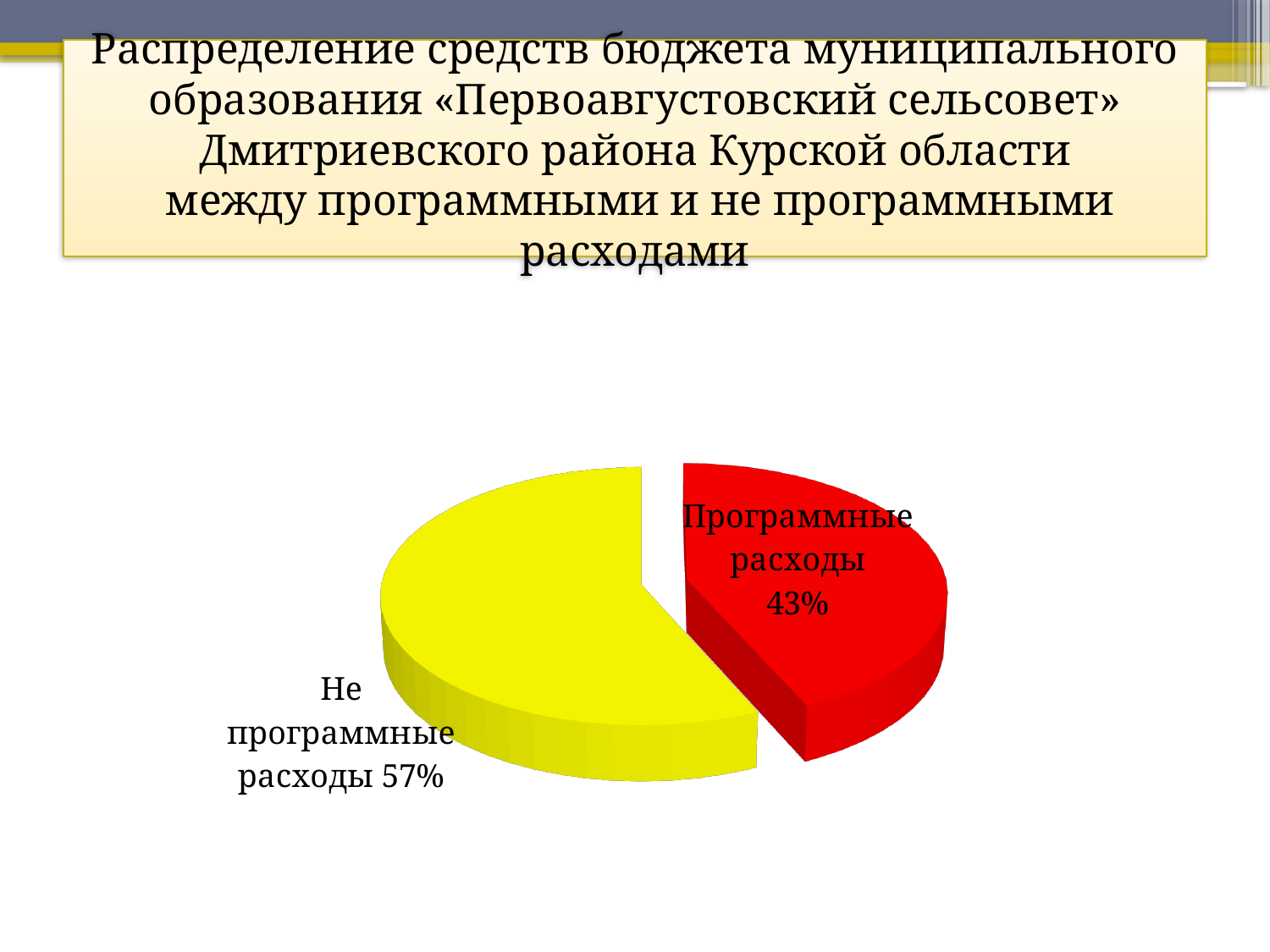
Which slice of the pie is the largest? Не программные расходы What kind of chart is shown on the slide? pie chart What is the difference in percentage points between "Не программные расходы" and "Программные расходы"? 14 What share of the pie is labelled "Не программные расходы"? 57% What colour is the slice for "Не программные расходы"? yellow How many slices does the pie chart have? 2 What colour is the slice for "Программные расходы"? red What share of the pie is labelled "Программные расходы"? 43% Is the share for "Не программные расходы" greater or less than 50%? greater Is the share for "Программные расходы" greater or less than 50%? less Which slice of the pie is the smallest? Программные расходы Which is larger: "Программные расходы" or "Не программные расходы"? Не программные расходы